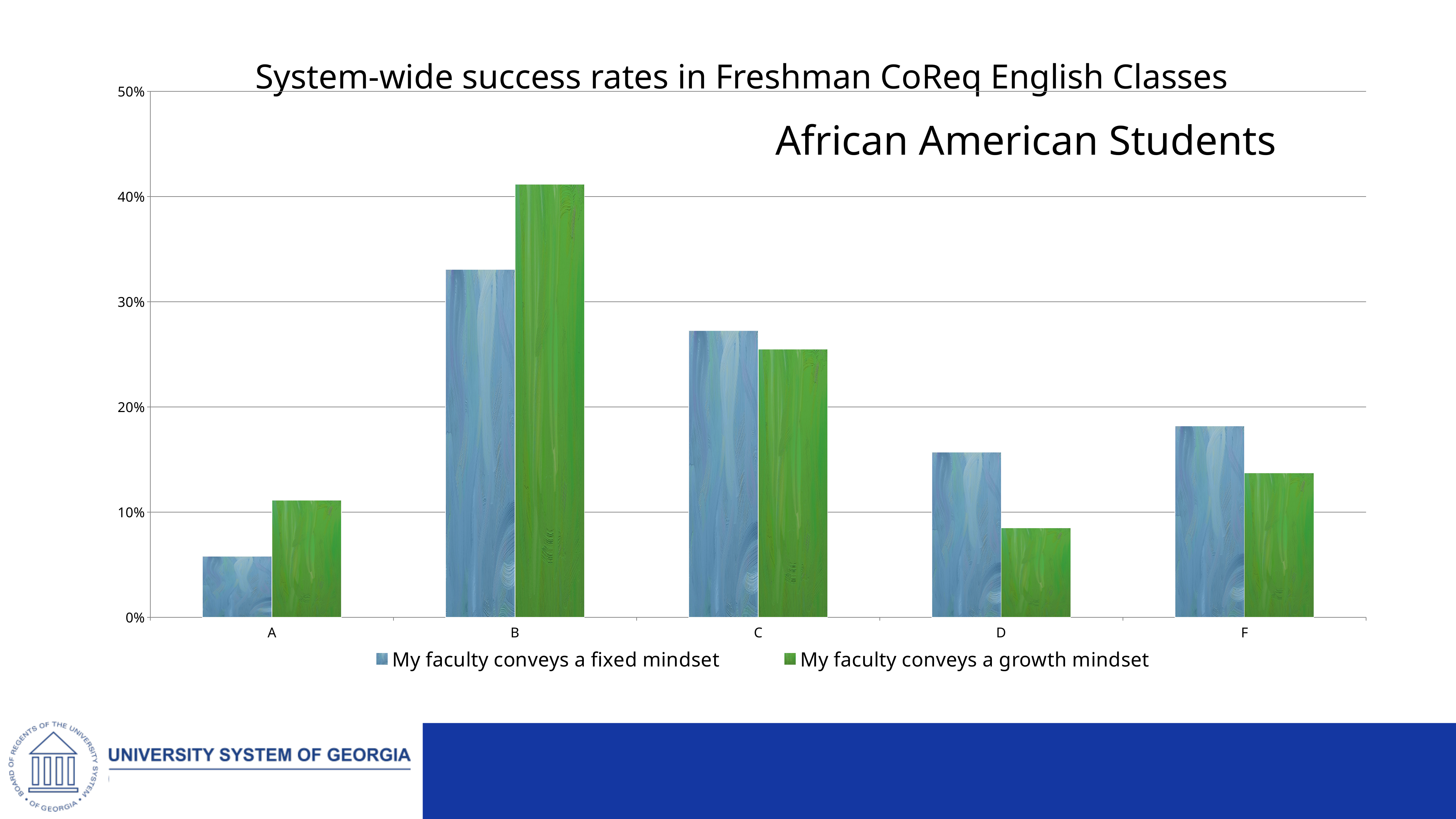
Which grade category has the lowest value for 'My faculty conveys a growth mindset'? D For grade B, which series has the larger value: 'My faculty conveys a fixed mindset' or 'My faculty conveys a growth mindset'? My faculty conveys a growth mindset Which student group does the chart subtitle say the data is for? African American Students For grade D, which series has the larger value: 'My faculty conveys a fixed mindset' or 'My faculty conveys a growth mindset'? My faculty conveys a fixed mindset Which grade category has the highest value for 'My faculty conveys a fixed mindset'? B Which grade category has the lowest value for 'My faculty conveys a fixed mindset'? A What kind of chart is shown on the slide? bar chart How many grade categories are shown on the x axis? 5 How many series does the legend list? 2 Is the value for 'My faculty conveys a growth mindset' at grade B greater or less than 40%? greater Is the value for 'My faculty conveys a fixed mindset' at grade A greater or less than 10%? less Which grade category has the highest value for 'My faculty conveys a growth mindset'? B